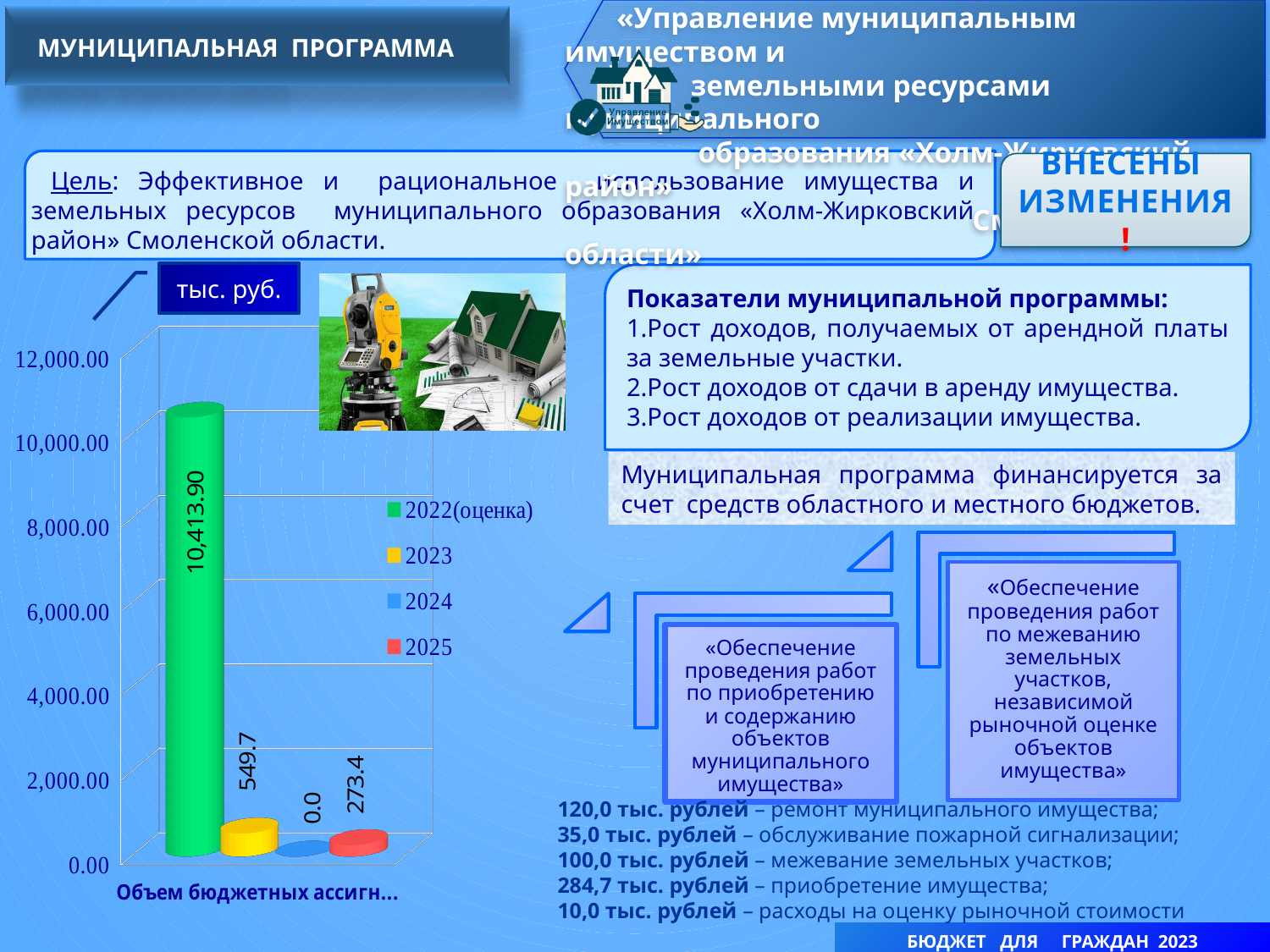
Which series has the lowest value in the chart? 2024 How many series does the chart legend list? 4 What is the value for the 2022(оценка) series in the chart? 10,413.90 What is the difference between the 2023 value and the 2025 value in the chart? 276.3 What is the value for the 2025 series in the chart? 273.4 What kind of chart is shown on the slide? bar chart What is the value for the 2024 series in the chart? 0.0 Which is larger in the chart, the value for 2023 or the value for 2025? 2023 What is the value for the 2023 series in the chart? 549.7 Which series has the highest value in the chart? 2022(оценка) Is the value for 2022(оценка) greater or less than 10,000.00? greater What unit is indicated for the values in the chart? тыс. руб.